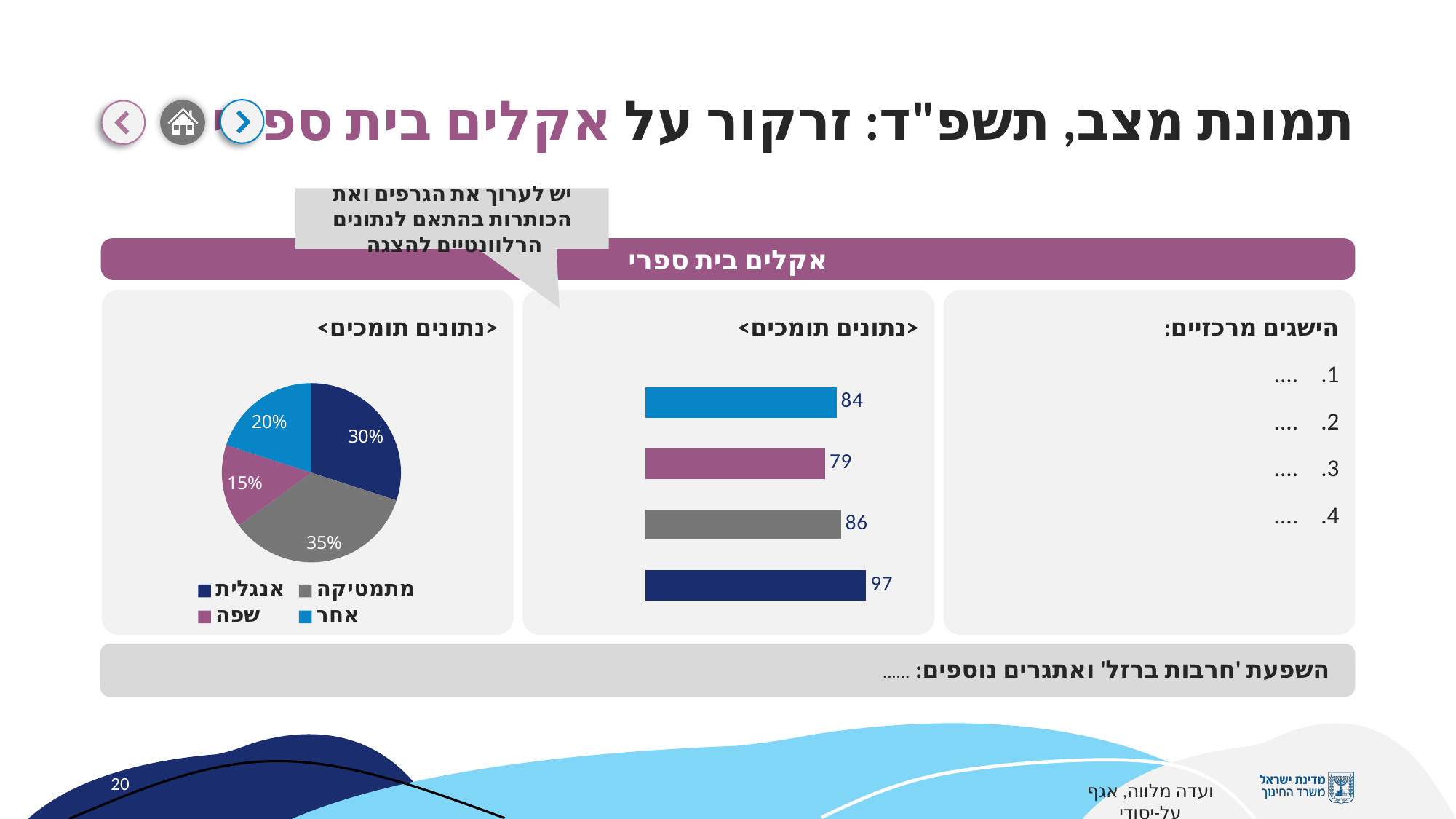
In the pie chart on the left, what is the difference between the shares of מתמטיקה and אחר? 15% In the pie chart on the left, which category has the largest slice? מתמטיקה In the bar chart in the middle panel, what is the value of the top (light blue) bar? 84 What kind of chart is the chart in the middle panel of the slide? bar chart In the bar chart in the middle panel, what is the difference between the bottom bar and the second bar from the top? 18 In the pie chart on the left, what share does שפה have? 15% In the pie chart on the left, which category has the smallest slice? שפה In the bar chart in the middle panel, which bar has the lowest value? the second bar from the top (purple), 79 In the pie chart on the left, what share does מתמטיקה have? 35% In the pie chart on the left, how many categories does the legend list? 4 In the bar chart in the middle panel, what is the value of the bottom (navy) bar? 97 In the pie chart on the left, what share does אנגלית have? 30%